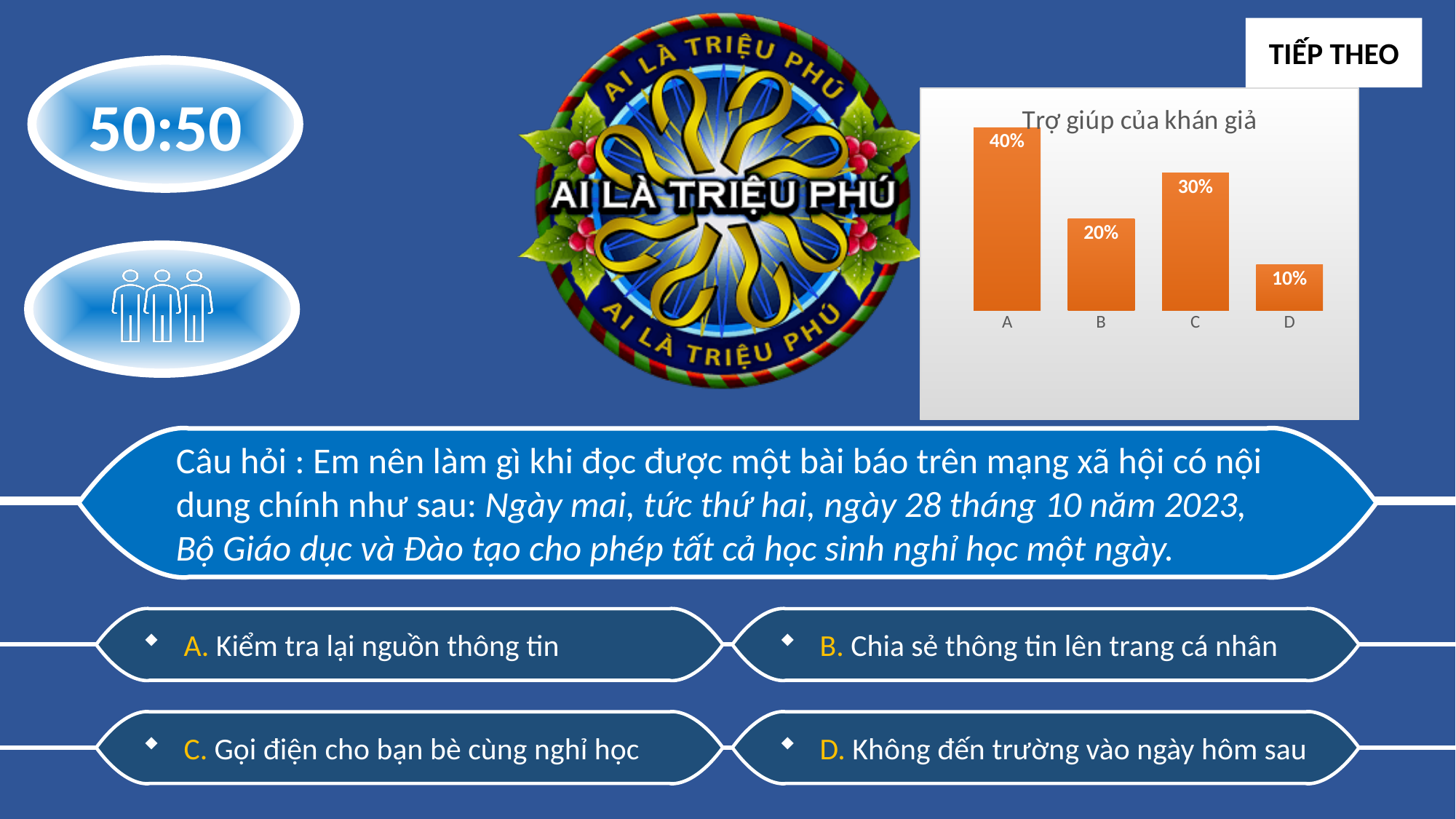
Which category has the lowest value in the chart? D What kind of chart is shown on the slide? Bar chart Which is larger, the value for B or the value for C? C What is the difference between the values for B and D? 10% Which category has the highest value in the chart? A What is the value for category D in the chart? 10% What is the value for category C in the chart? 30% How many categories are shown in the chart? 4 What is the value for category A in the chart? 40% What is the difference between the values for A and C? 10% What is the title of the chart? Trợ giúp của khán giả What is the value for category B in the chart? 20%